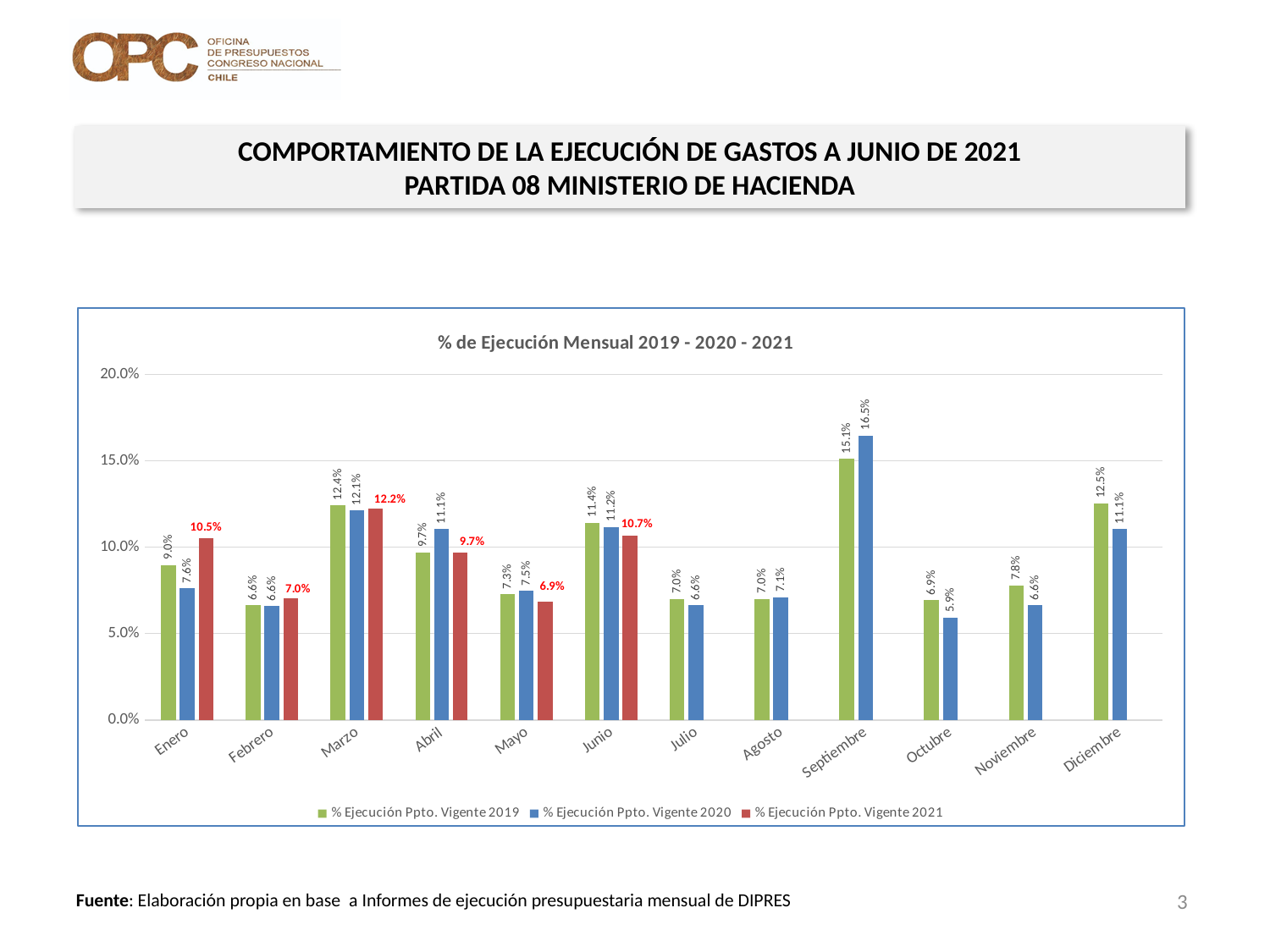
Which month has the highest value in the % Ejecución Ppto. Vigente 2020 series? Septiembre Which month has the highest value in the % Ejecución Ppto. Vigente 2021 series? Marzo Which is larger for Abril: the 2019 value or the 2020 value? 2020 What is the difference between the 2020 and 2019 values for Septiembre? 1.4% Which month has the lowest value in the % Ejecución Ppto. Vigente 2020 series? Octubre How many months are shown on the x axis? 12 What is the value for Enero in the % Ejecución Ppto. Vigente 2021 series? 10.5% What kind of chart is shown on the slide? Bar chart What is the value for Septiembre in the % Ejecución Ppto. Vigente 2020 series? 16.5% How many series does the legend list? 3 Is the value for Marzo in the 2019 series greater or less than 10.0%? greater What is the value for Diciembre in the % Ejecución Ppto. Vigente 2019 series? 12.5%